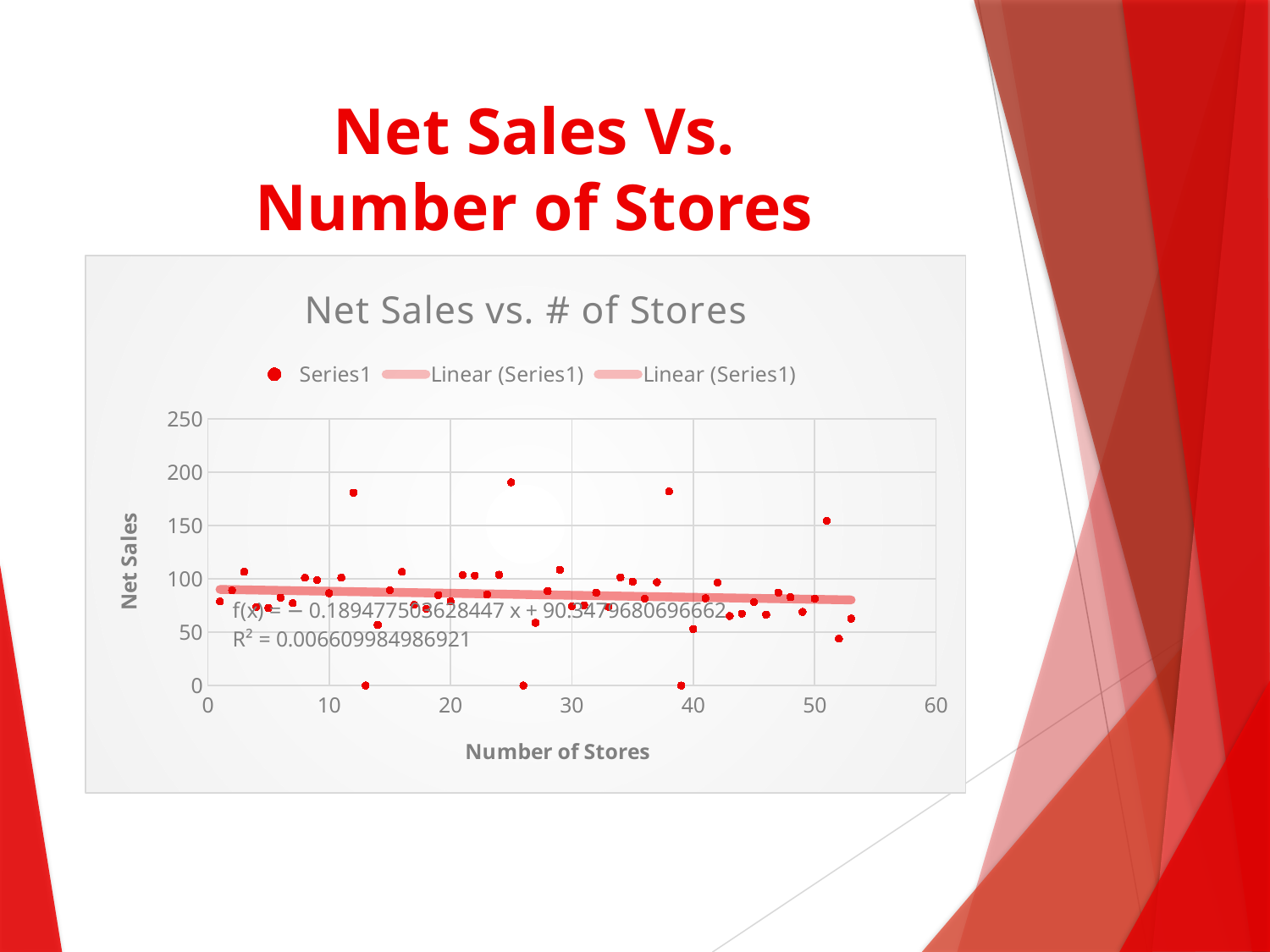
What is the slope of the trendline equation printed on the chart? −0.189477503628447 How many entries does the chart legend list? 3 What is the R² value printed on the chart? 0.006609984986921 What kind of chart is shown on the slide? Scatter chart Does the linear trendline rise or fall as the number of stores increases? Fall What is the label of the x axis? Number of Stores Is the lowest Net Sales value plotted greater or less than 50? less What is the maximum value shown on the Net Sales axis? 250 What is the title of the chart? Net Sales vs. # of Stores Is the highest Net Sales value plotted greater or less than 150? greater